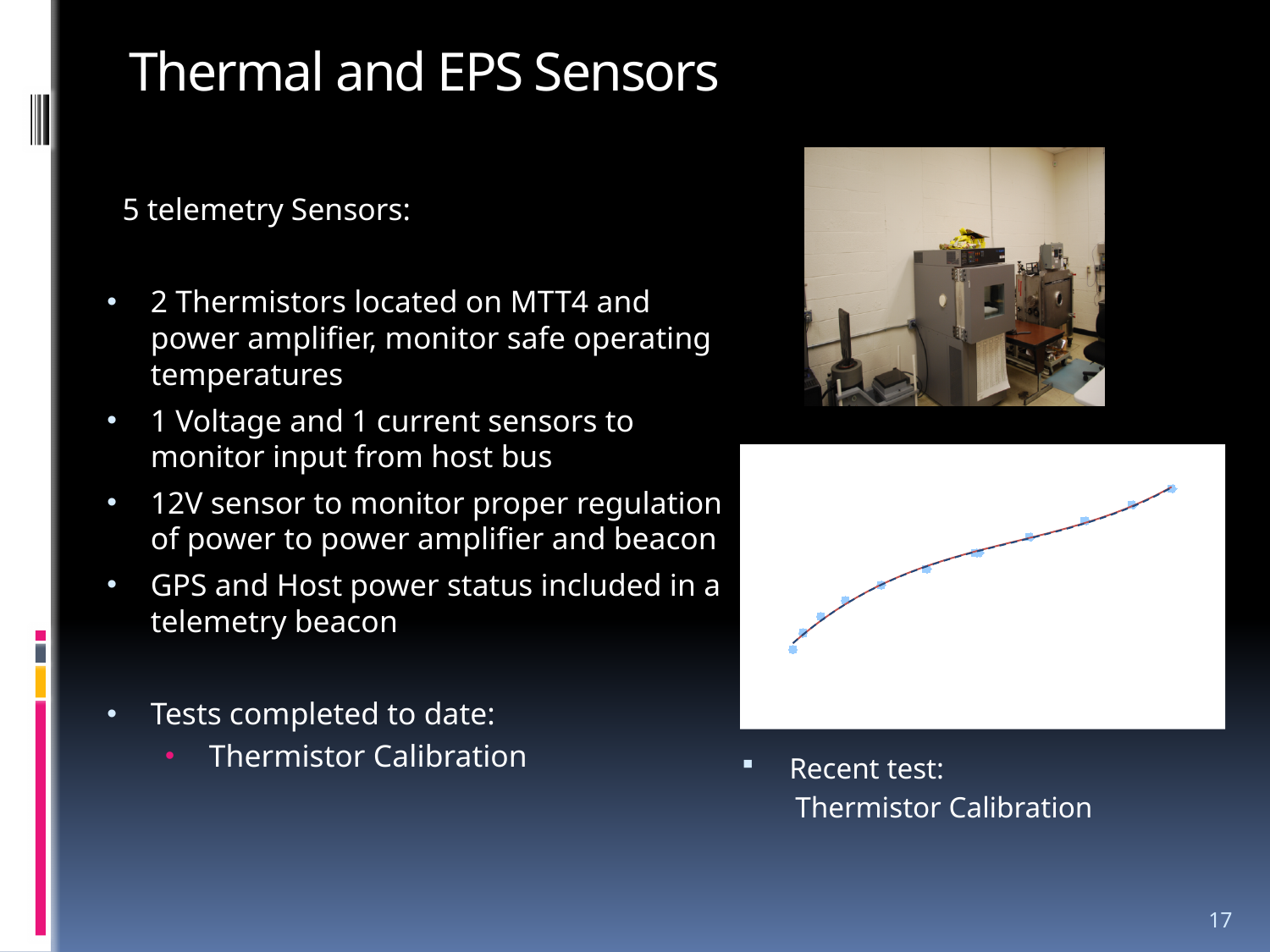
What kind of chart is shown on the right side of the slide? Line chart with data point markers According to the caption below the chart, which test does the chart show? Thermistor Calibration Do the plotted values rise or fall from left to right along the x axis? Rise What colour are the data point markers on the chart? Blue